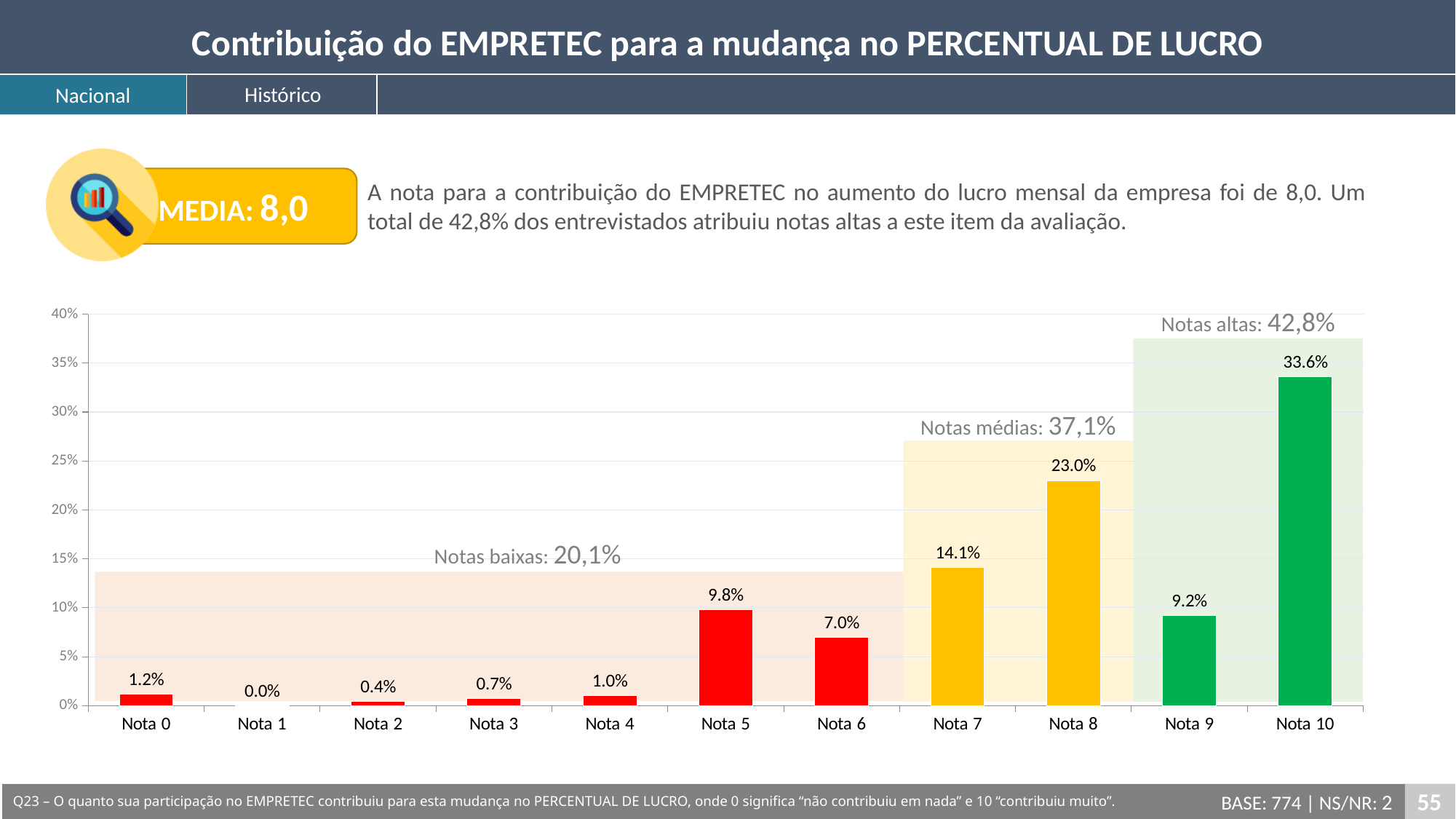
Which category has the highest value? Nota 10 Is the value for Nota 8 greater or less than 20%? greater What kind of chart is shown on the slide? bar chart What is the difference between the values for Nota 10 and Nota 8? 10.6% What percentage is shown for 'Notas altas' on the chart? 42,8% What is the value for Nota 2? 0.4% How many categories are shown on the x axis? 11 Which category has the lowest value? Nota 1 What is the value for Nota 10? 33.6% Which is larger, the value for Nota 5 or the value for Nota 6? Nota 5 What is the value for Nota 8? 23.0% What is the value for Nota 5? 9.8%